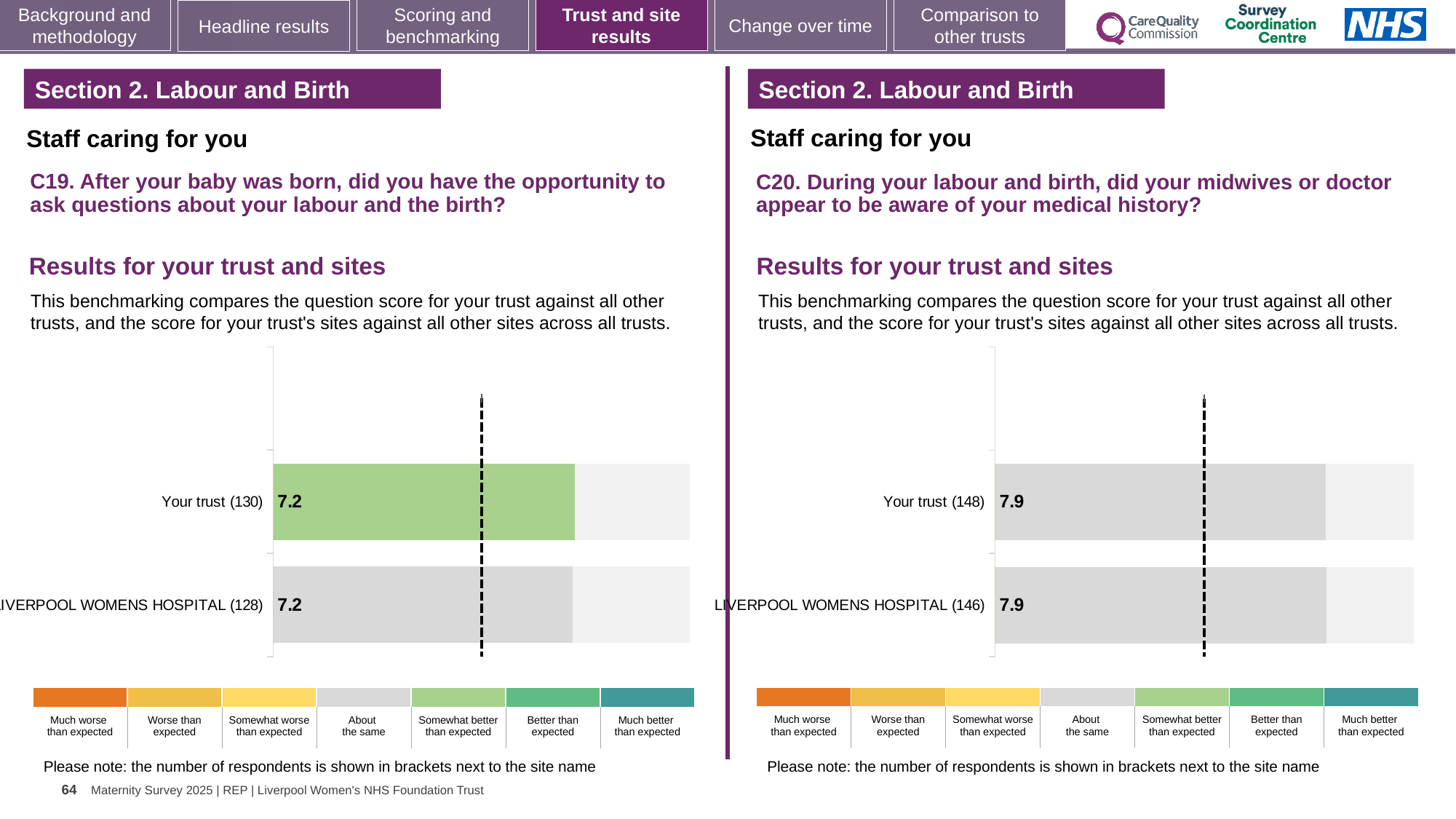
On the right chart (C20), what is the score for LIVERPOOL WOMENS HOSPITAL? 7.9 On the left chart (C19), what is the score for Your trust? 7.2 On the left chart (C19), what is the difference between the Your trust score and the LIVERPOOL WOMENS HOSPITAL score? 0.0 On the right chart (C20), what is the difference between the Your trust score and the LIVERPOOL WOMENS HOSPITAL score? 0.0 On the left chart (C19), which benchmark category does the colour of the Your trust bar correspond to in the legend? Somewhat better than expected What kind of chart is used on the left (C19)? Bar chart On the left chart (C19), how many respondents are shown in brackets for Your trust? 130 How many bars are plotted on the left chart (C19)? 2 On the left chart (C19), what is the score for LIVERPOOL WOMENS HOSPITAL? 7.2 On the right chart (C20), what is the score for Your trust? 7.9 On the right chart (C20), how many respondents are shown in brackets for LIVERPOOL WOMENS HOSPITAL? 146 How many bars are plotted on the right chart (C20)? 2